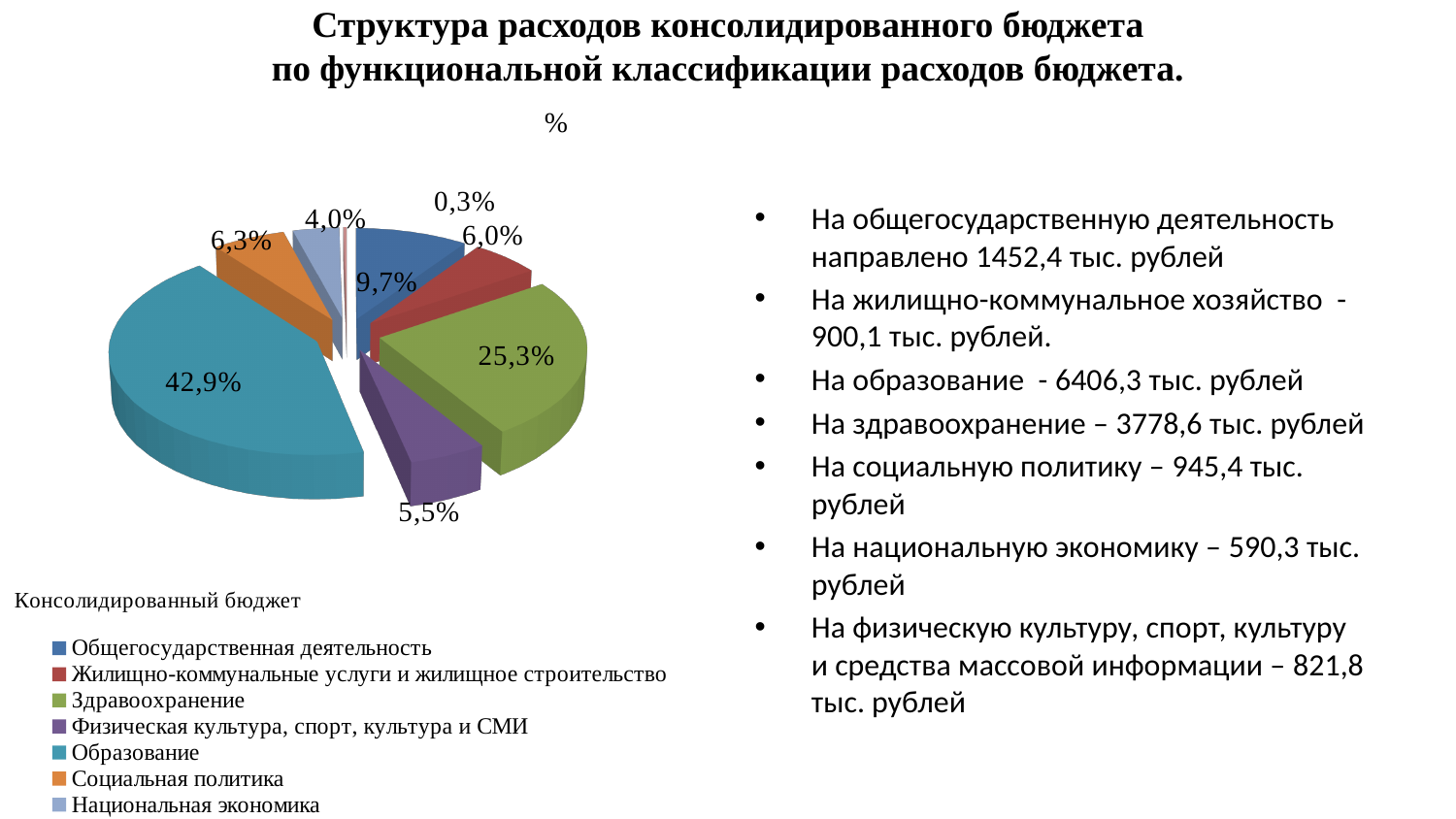
What share of the pie does Здравоохранение have? 25,3% What type of chart is shown on the slide? pie chart What share of the pie does Физическая культура, спорт, культура и СМИ have? 5,5% What is the difference between the shares of Образование and Здравоохранение? 17,6% What share of the pie does Социальная политика have? 6,3% Which category has the largest share of the pie? Образование What is the smallest percentage value labelled on the pie chart? 0,3% Which has a larger share: Жилищно-коммунальные услуги и жилищное строительство or Социальная политика? Социальная политика What share of the pie does Общегосударственная деятельность have? 9,7% What share of the pie does Образование have? 42,9% What share of the pie does Национальная экономика have? 4,0% How many entries does the chart legend list? 7